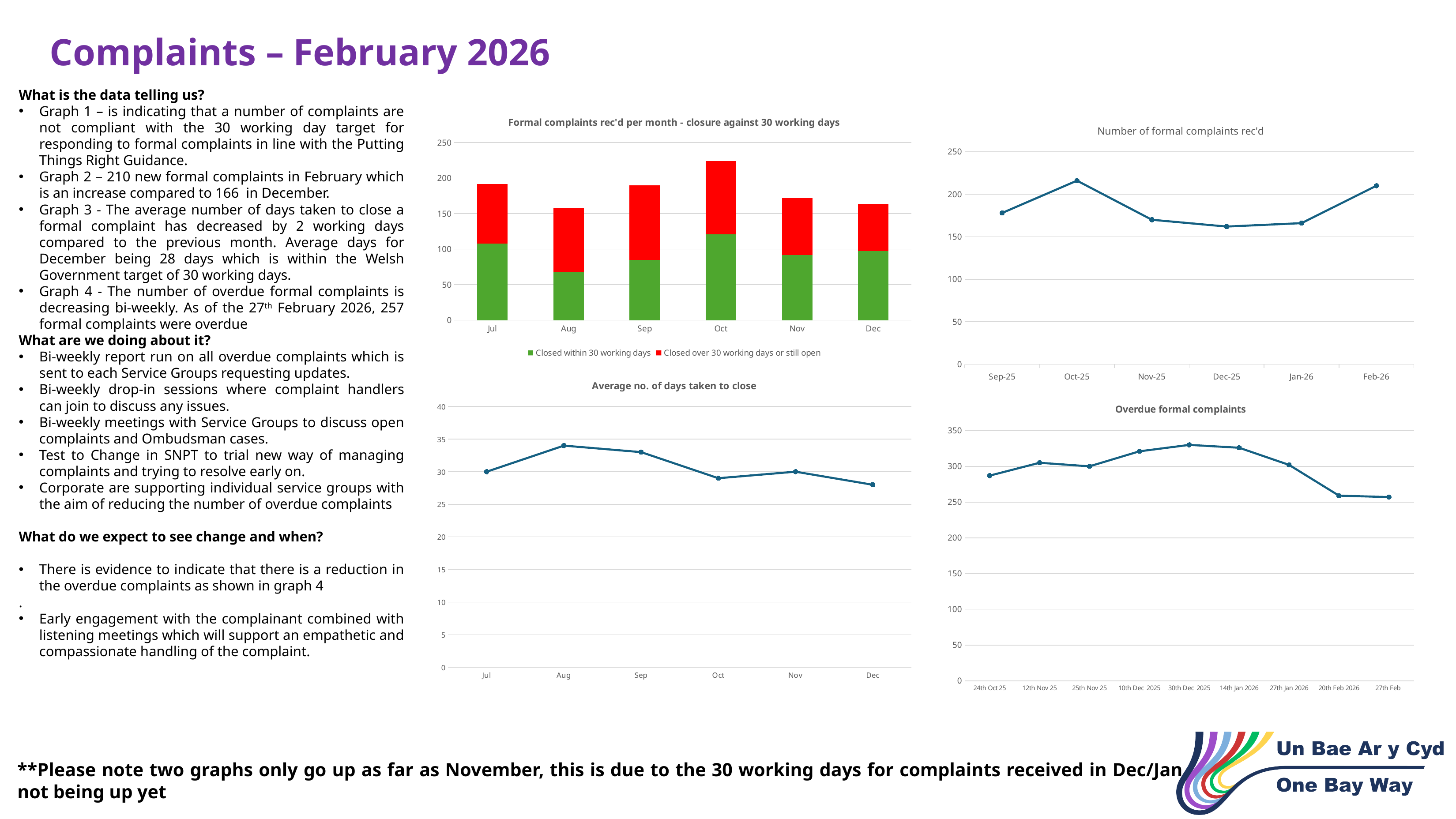
In the 'Average no. of days taken to close' chart, which month has the highest value? Aug What kind of chart is 'Average no. of days taken to close'? Line chart In the 'Average no. of days taken to close' chart, which month has the lowest value? Dec In the 'Formal complaints rec'd per month - closure against 30 working days' chart, which month has the tallest stacked bar? Oct In the 'Number of formal complaints rec'd' chart, which month has the highest value? Oct-25 In the 'Formal complaints rec'd per month - closure against 30 working days' chart, which month has the shortest stacked bar? Aug In the 'Formal complaints rec'd per month - closure against 30 working days' chart, is the total bar for Oct greater or less than 200? greater In the 'Number of formal complaints rec'd' chart, how many months are plotted on the x axis? 6 In the 'Number of formal complaints rec'd' chart, which month has the lowest value? Dec-25 In the 'Formal complaints rec'd per month - closure against 30 working days' chart, how many series does the legend list? 2 In the 'Formal complaints rec'd per month - closure against 30 working days' chart, which colour represents 'Closed within 30 working days'? Green In the 'Overdue formal complaints' chart, is the value for 24th Oct 25 greater or less than 300? less